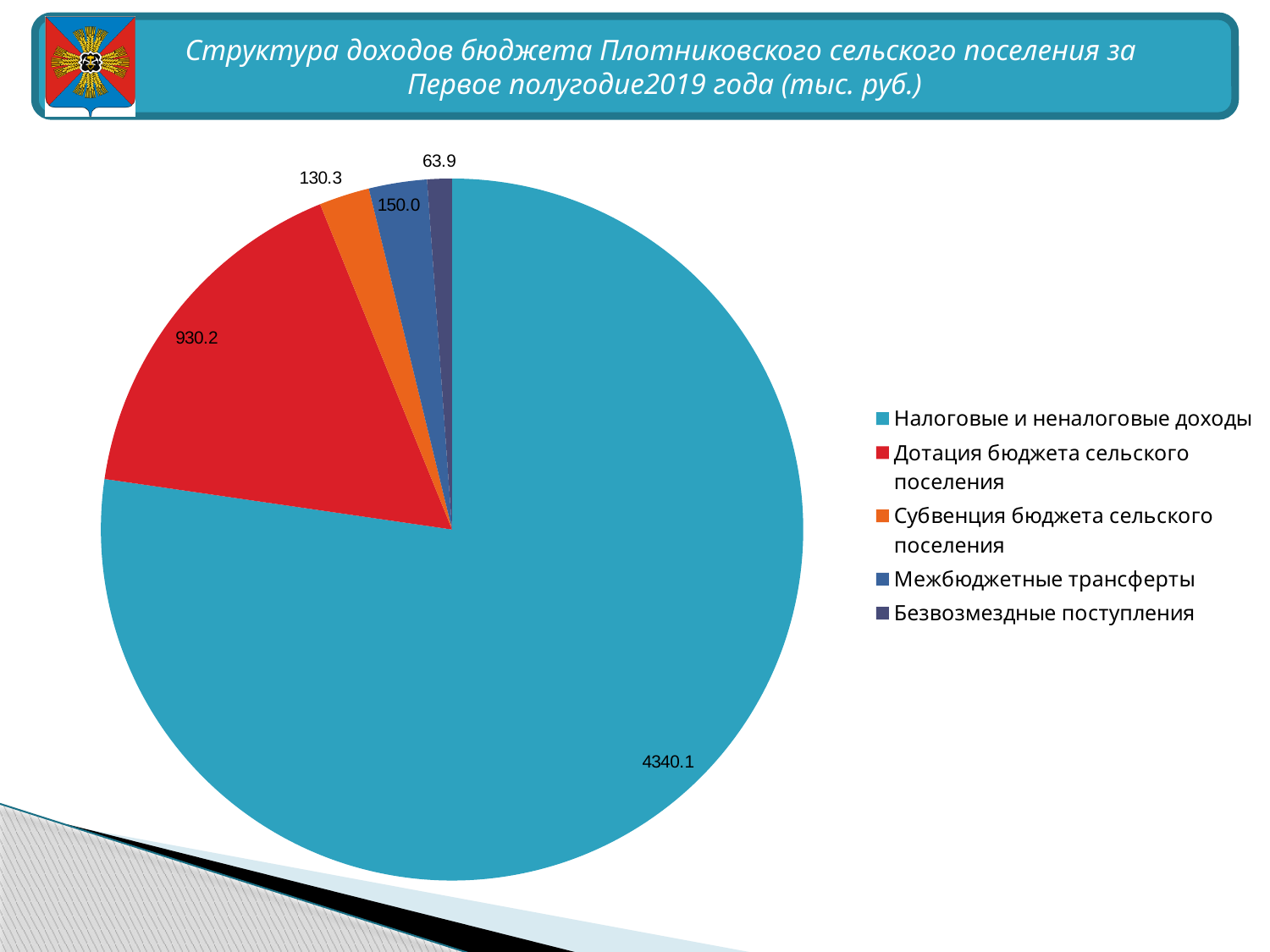
What type of chart is shown on the slide? pie chart What is the value for Субвенция бюджета сельского поселения? 130.3 How many categories does the pie chart have? 5 Which category has the largest slice of the pie? Налоговые и неналоговые доходы What is the difference between Дотация бюджета сельского поселения and Субвенция бюджета сельского поселения? 799.9 What is the value for Налоговые и неналоговые доходы? 4340.1 Which category has the smallest slice of the pie? Безвозмездные поступления What is the value for Межбюджетные трансферты? 150.0 What colour is the slice for Дотация бюджета сельского поселения? red Which is larger, Межбюджетные трансферты or Безвозмездные поступления? Межбюджетные трансферты What is the value for Безвозмездные поступления? 63.9 What is the value for Дотация бюджета сельского поселения? 930.2